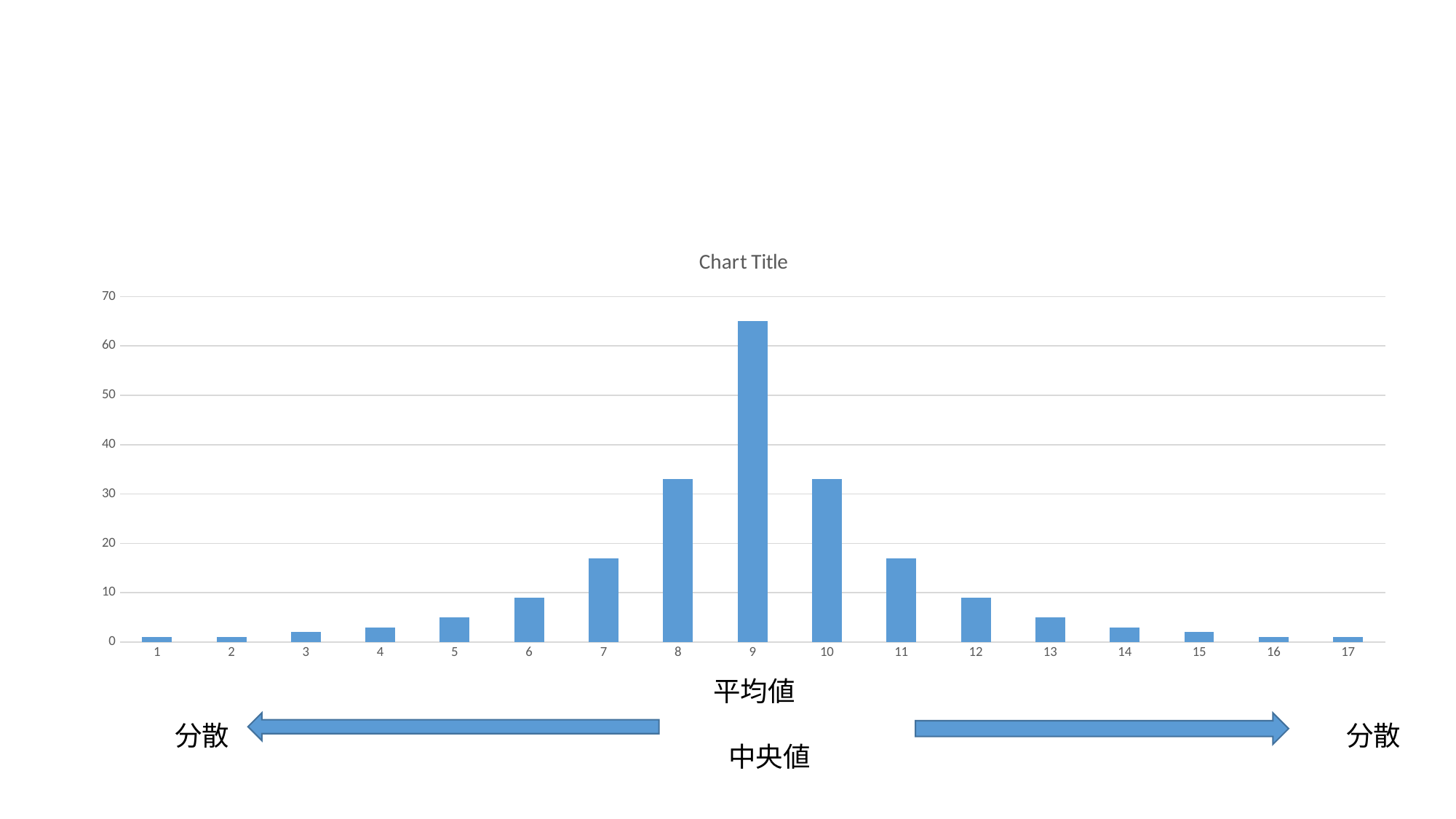
Is the value for category 12 greater or less than 10? less What is the title of the chart? Chart Title What kind of chart is shown on the slide? bar chart Which category has the highest bar in the chart? 9 Which has the larger value, category 8 or category 7? 8 Is the value for category 7 greater or less than 20? less Is the value for category 9 greater or less than 60? greater How many categories are shown on the x axis of the chart? 17 Which has the larger value, category 9 or category 11? 9 Do the values rise or fall from category 1 to category 9? rise